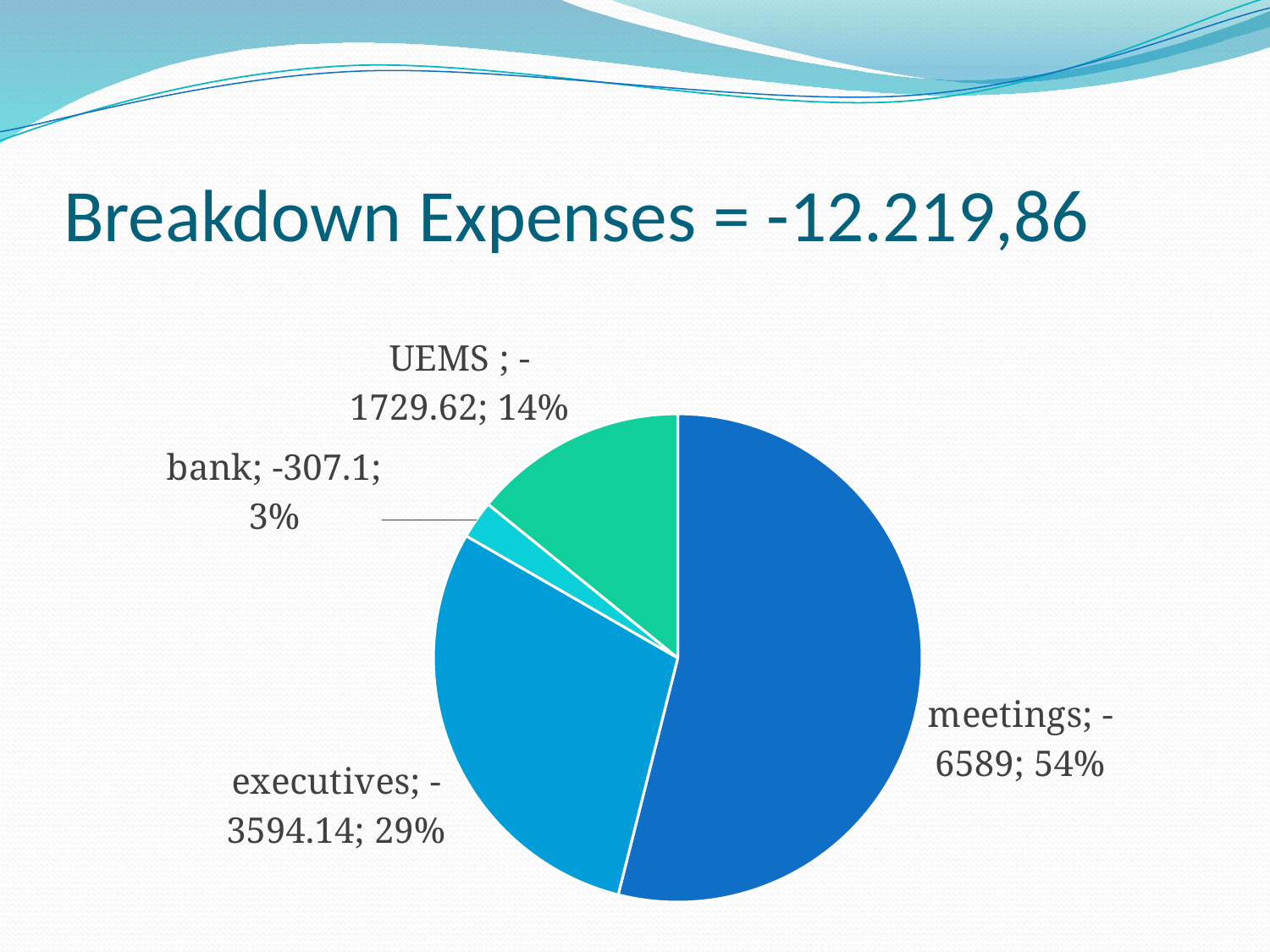
What is the value shown for bank? -307.1 What share of the pie does executives represent? 29% Which category has the largest slice of the pie? meetings What is the value shown for meetings? -6589 What share of the pie does meetings represent? 54% Which slice is larger, UEMS or executives? executives What kind of chart is shown on the slide? pie chart Which category has the smallest slice of the pie? bank What is the value shown for UEMS? -1729.62 How many slices does the pie chart have? 4 What is the value shown for executives? -3594.14 What is the title of the chart on the slide? Breakdown Expenses = -12.219,86